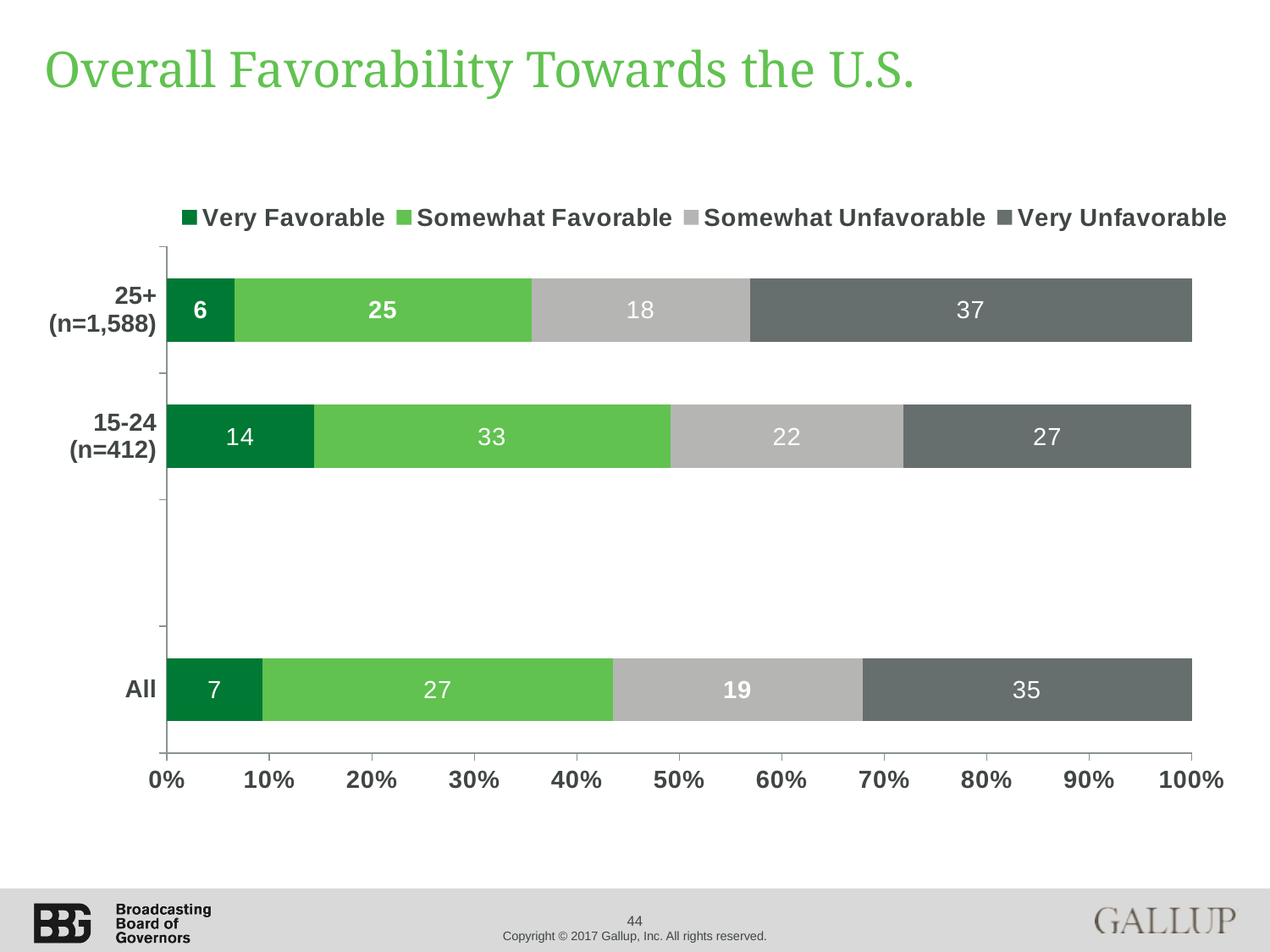
Which group has the lowest Very Unfavorable value? 15-24 (n=412) What is the difference between the Very Unfavorable values for 25+ (n=1,588) and 15-24 (n=412)? 10 What is the total of the Very Favorable and Somewhat Favorable values for the 15-24 (n=412) group? 47 Which is larger: the Somewhat Favorable value for All or for 25+ (n=1,588)? All Which group has the highest Very Favorable value? 15-24 (n=412) What is the Very Unfavorable value for the 25+ (n=1,588) group? 37 How many series does the legend list? 4 How many groups are shown on the chart? 3 What is the title of the chart? Overall Favorability Towards the U.S. What is the Somewhat Unfavorable value for All? 19 What kind of chart is shown on the slide? Stacked bar chart What is the Somewhat Favorable value for the 15-24 (n=412) group? 33